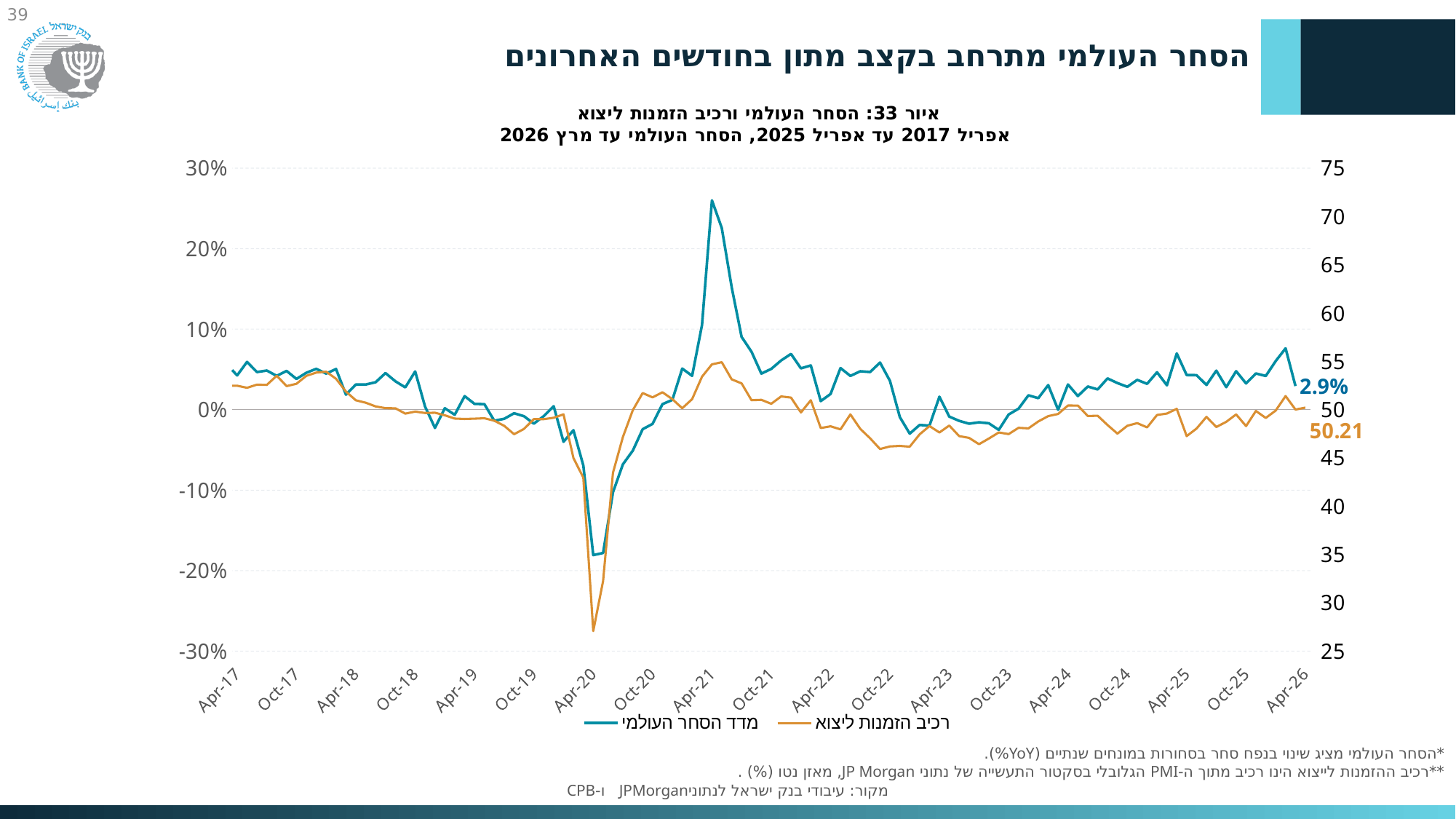
Is the value of the export orders component (רכיב הזמנות ליצוא) at Apr-20 greater or less than 35? less What is the latest labelled value of the world trade index (מדד הסחר העולמי) series? 2.9% Between Apr-21 and Apr-23, does the world trade index (מדד הסחר העולמי) generally rise or fall? fall What is the figure number given in the chart title? איור 33 What kind of chart is shown on the slide? line chart At which x-axis label does the export orders component (רכיב הזמנות ליצוא) reach its lowest point? Apr-20 What is the latest labelled value of the export orders component (רכיב הזמנות ליצוא) series? 50.21 How many series does the legend list? 2 At which x-axis label does the world trade index (מדד הסחר העולמי) reach its highest point? Apr-21 Is the value of the world trade index (מדד הסחר העולמי) at Apr-20 greater or less than -10%? less Is the value of the world trade index (מדד הסחר העולמי) at Apr-21 greater or less than 20%? greater Which two series are listed in the legend? מדד הסחר העולמי and רכיב הזמנות ליצוא